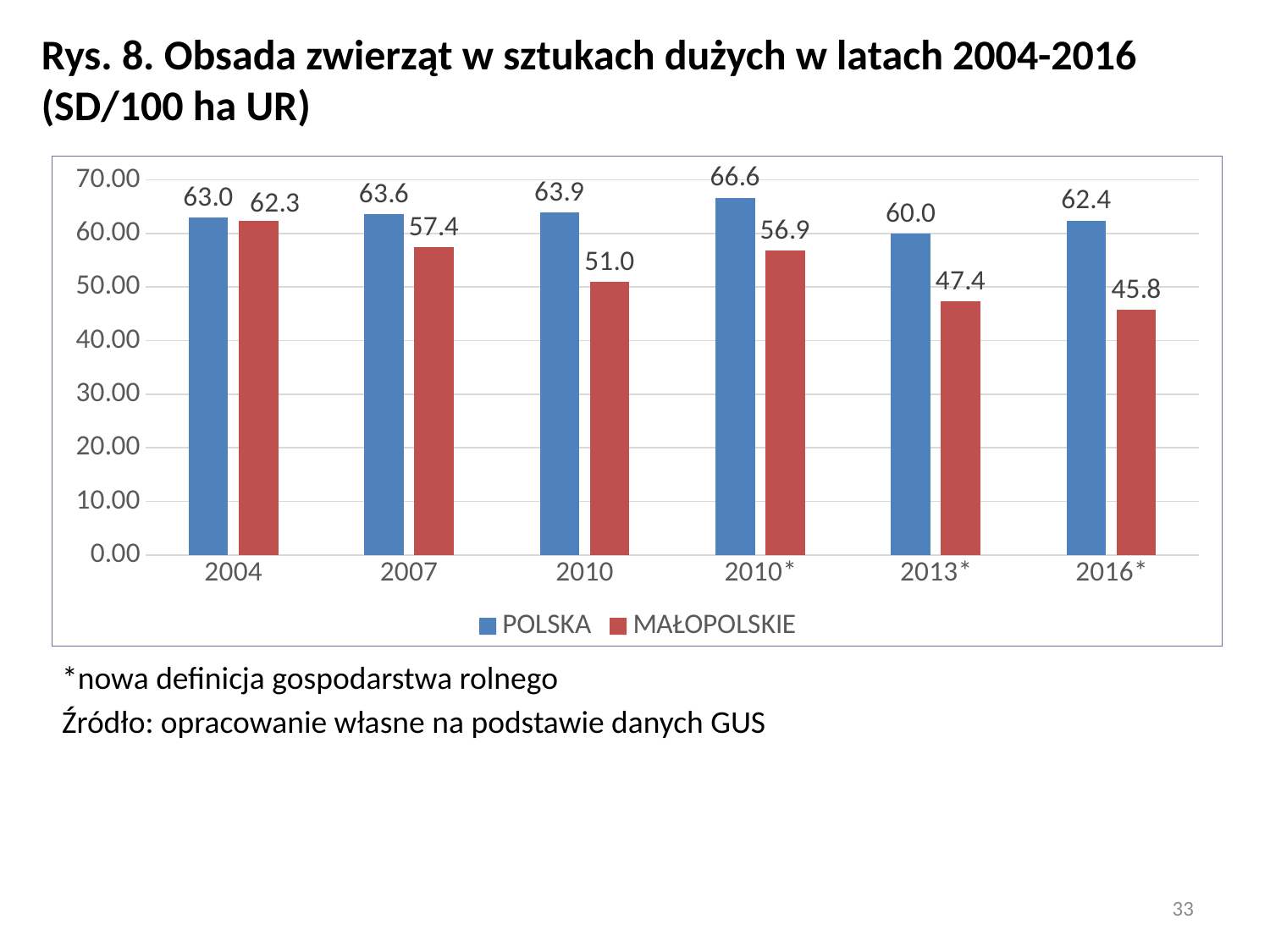
What is the value for MAŁOPOLSKIE in 2010? 51.0 What is the difference between the POLSKA and MAŁOPOLSKIE values in 2013*? 12.6 In which year is the POLSKA value highest? 2010* What kind of chart is shown on the slide? bar chart What is the value for MAŁOPOLSKIE in 2016*? 45.8 Which colour represents MAŁOPOLSKIE in the chart? red In which year is the MAŁOPOLSKIE value lowest? 2016* How many series does the legend list? 2 Which is larger in 2007: the POLSKA value or the MAŁOPOLSKIE value? POLSKA How many year categories are shown on the x axis? 6 What is the value for POLSKA in 2004? 63.0 Is the value for MAŁOPOLSKIE in 2013* greater or less than 50.00? less